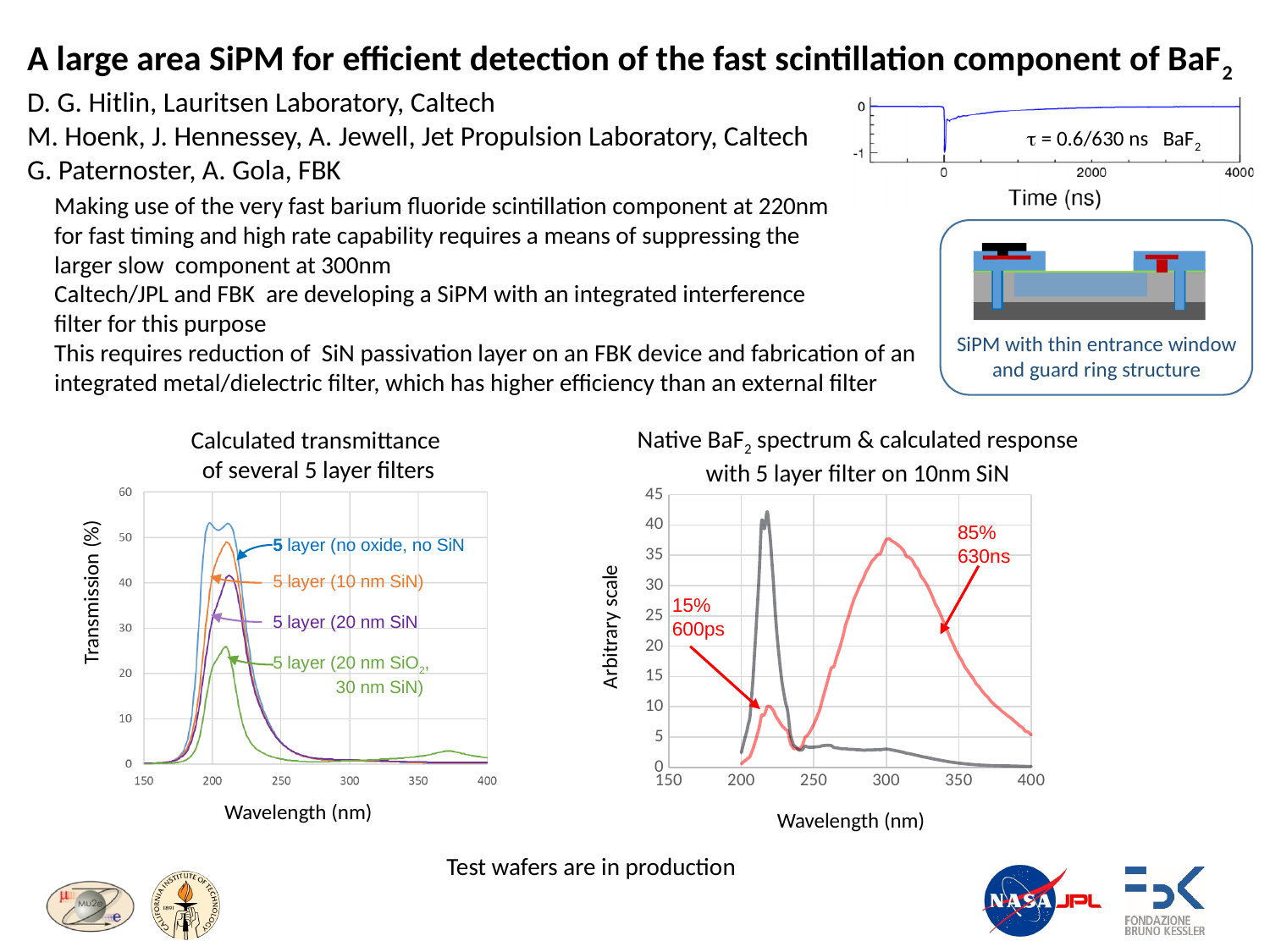
In the 'Native BaF2 spectrum & calculated response' chart, is the peak of the grey curve near 220 nm greater or less than 40? greater What kind of chart is the 'Calculated transmittance of several 5 layer filters' chart? line chart How many filter curves are plotted in the 'Calculated transmittance of several 5 layer filters' chart? 4 In the 'Native BaF2 spectrum & calculated response' chart, does the pink curve rise or fall between 300 nm and 400 nm? fall What is the y-axis label of the 'Calculated transmittance of several 5 layer filters' chart? Transmission (%) What is the x-axis label of the small time-decay chart at the top right of the slide? Time (ns) In the 'Native BaF2 spectrum & calculated response' chart, is the peak of the pink curve near 300 nm greater or less than 40? less In the 'Calculated transmittance of several 5 layer filters' chart, is the peak transmission of the 5 layer (20 nm SiO2, 30 nm SiN) filter greater or less than 30? less In the 'Native BaF2 spectrum & calculated response' chart, which peak is higher: the grey curve peak near 220 nm or the pink curve peak near 300 nm? the grey curve peak near 220 nm In the 'Calculated transmittance of several 5 layer filters' chart, which filter reaches the highest peak transmission? 5 layer (no oxide, no SiN) In the 'Calculated transmittance of several 5 layer filters' chart, which filter has the lowest peak transmission? 5 layer (20 nm SiO2, 30 nm SiN)